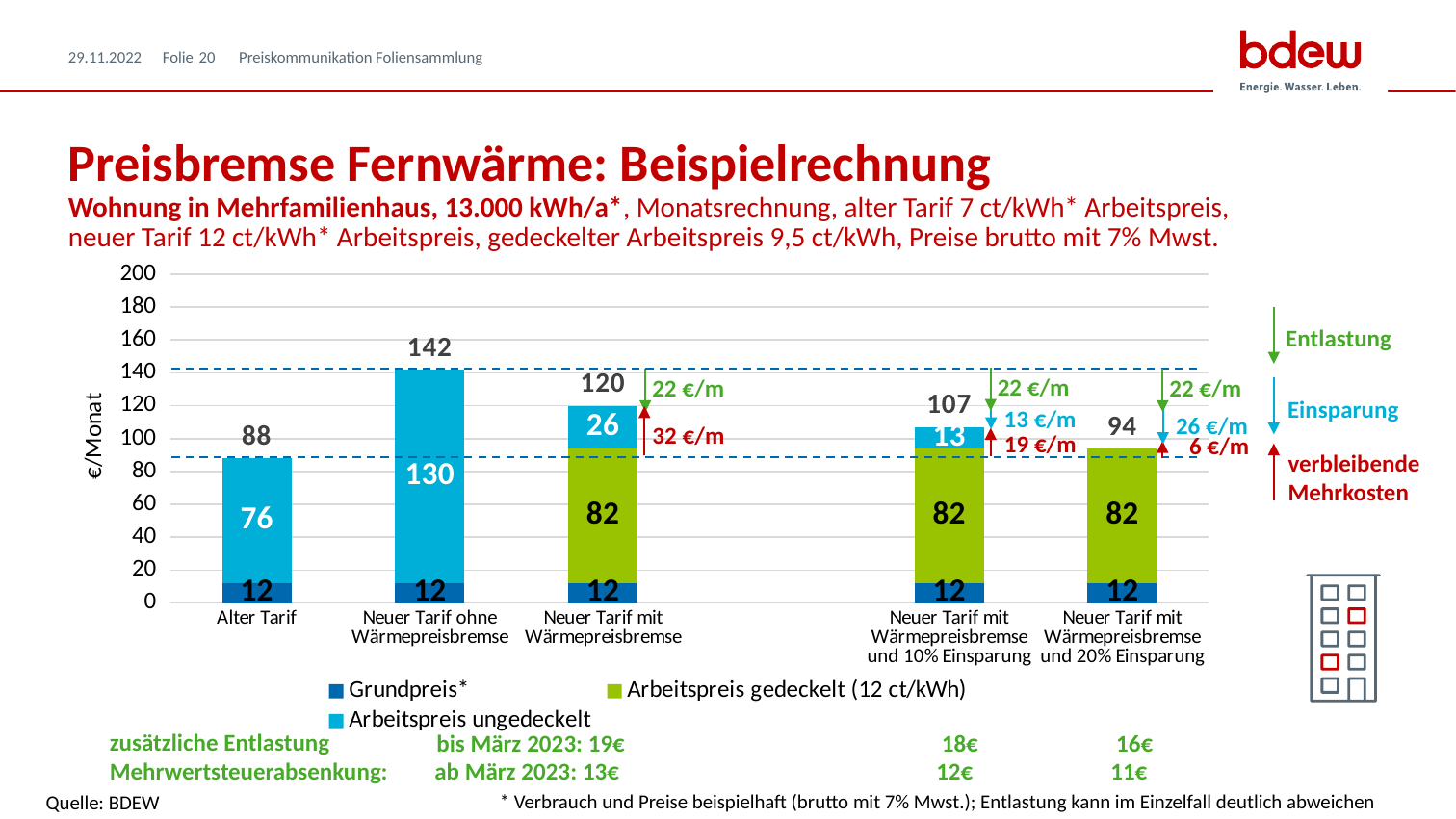
What is the value of the "Grundpreis*" segment in each bar? 12 What kind of chart is shown on the slide? Stacked bar chart What is the value of the "Arbeitspreis gedeckelt (12 ct/kWh)" segment in the "Neuer Tarif mit Wärmepreisbremse" bar? 82 Which category has the highest total monthly cost? Neuer Tarif ohne Wärmepreisbremse What is the total of the stacked bar for "Neuer Tarif mit Wärmepreisbremse und 20% Einsparung"? 94 What is the difference between the total for "Neuer Tarif ohne Wärmepreisbremse" and the total for "Alter Tarif"? 54 How many series does the legend list? 3 Which total is larger: "Neuer Tarif mit Wärmepreisbremse und 10% Einsparung" or "Neuer Tarif mit Wärmepreisbremse und 20% Einsparung"? Neuer Tarif mit Wärmepreisbremse und 10% Einsparung What is the value of the "Arbeitspreis ungedeckelt" segment in the "Alter Tarif" bar? 76 What is the total monthly cost shown above the bar for "Neuer Tarif ohne Wärmepreisbremse"? 142 Which category has the lowest total monthly cost? Alter Tarif How many bars (categories) are shown in the chart? 5